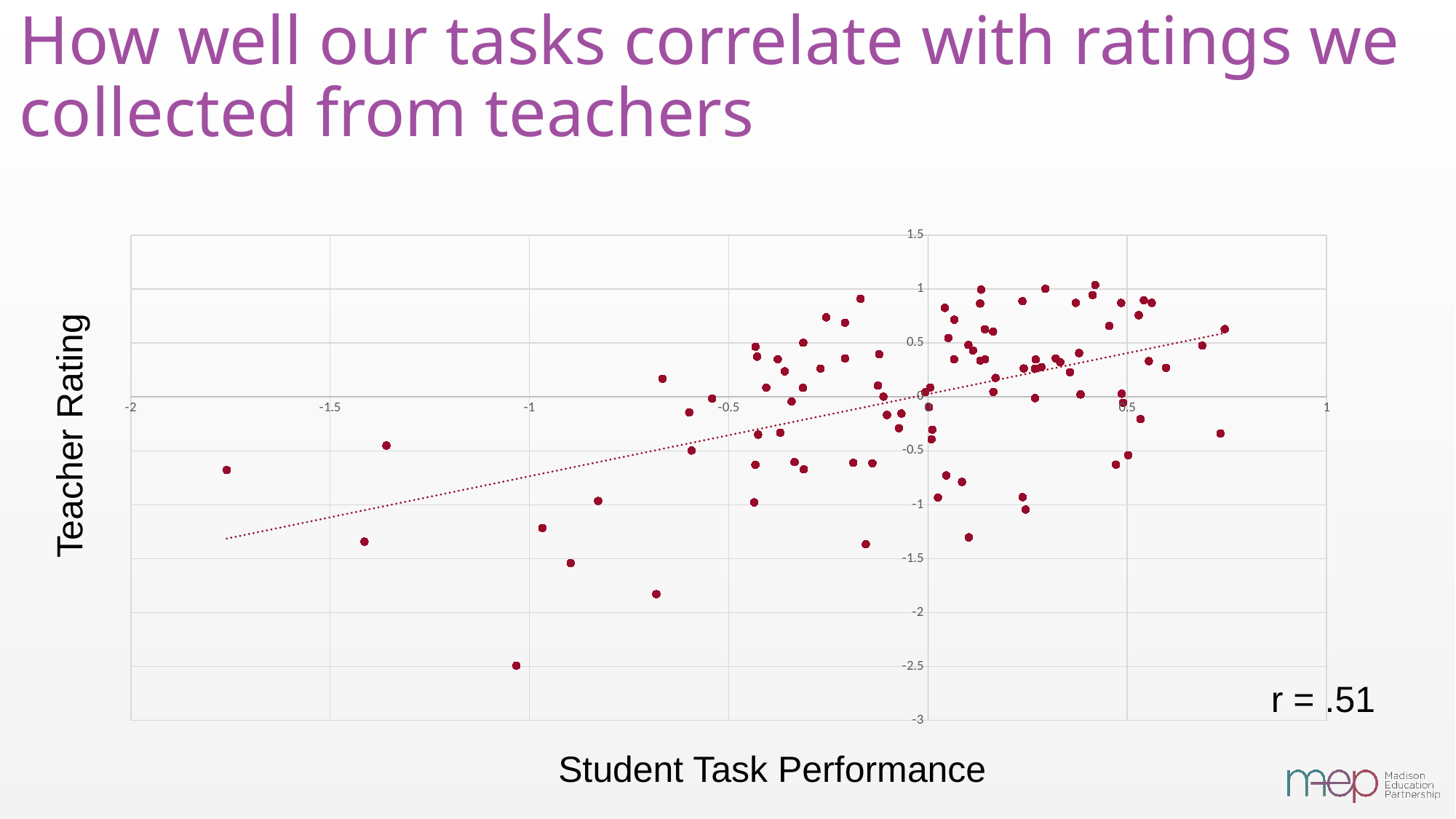
What kind of chart is shown on the slide? scatter plot Does the dotted trend line rise or fall as Student Task Performance increases? rises What is the minimum value shown on the x axis? -2 What is the label of the y axis? Teacher Rating What is the maximum value shown on the y axis? 1.5 Is the highest Teacher Rating plotted on the chart greater or less than 1.5? less Is the Student Task Performance of the rightmost point greater or less than 1? less What is the label of the x axis? Student Task Performance What correlation coefficient is printed on the chart? r = .51 Is the Student Task Performance of the leftmost point greater or less than -1.5? less